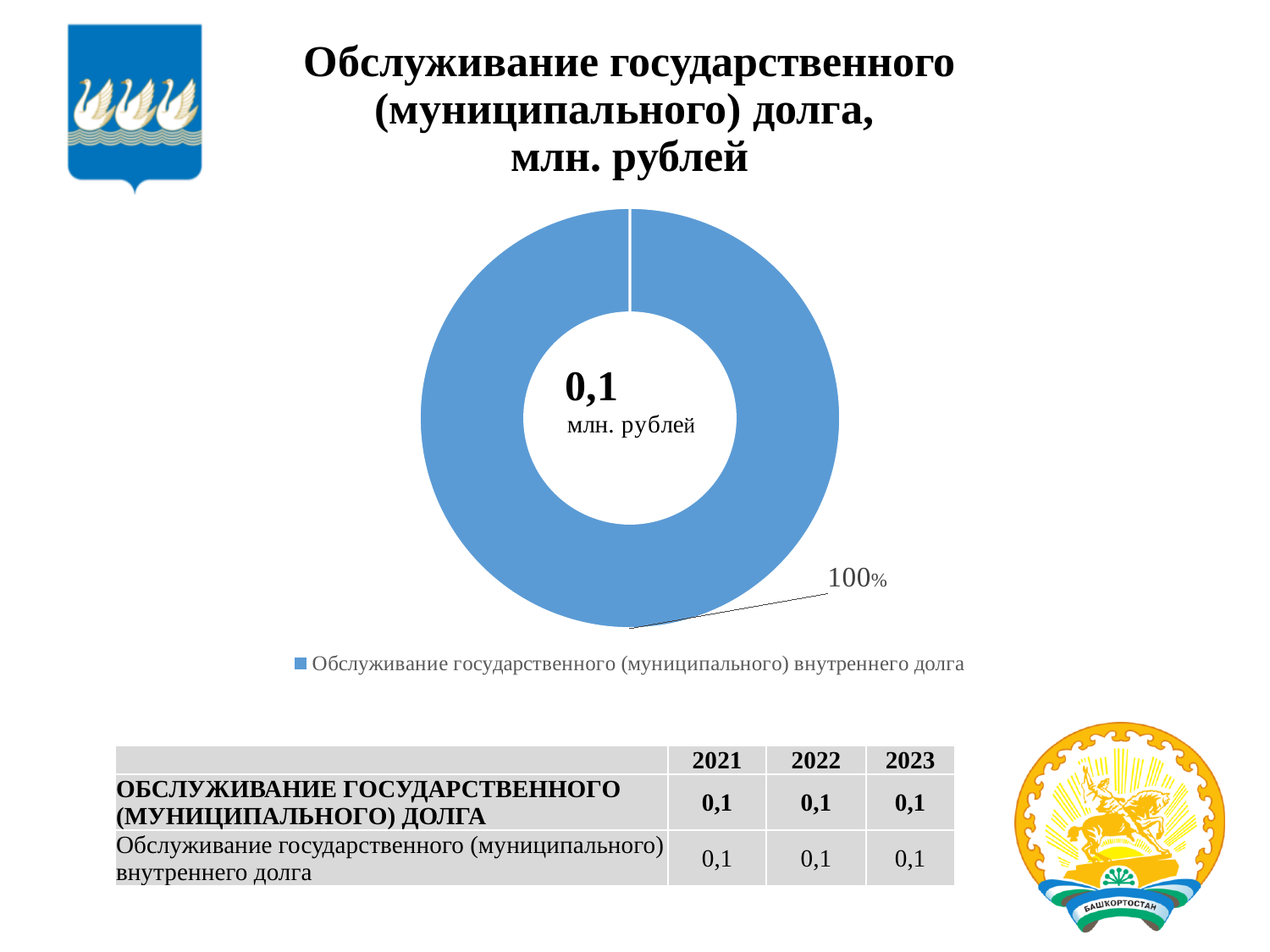
In the table below the chart, what is the value of "Обслуживание государственного (муниципального) долга" for 2022? 0,1 What share of the doughnut chart does the slice for "Обслуживание государственного (муниципального) внутреннего долга" represent? 100% What legend entry is shown below the chart? Обслуживание государственного (муниципального) внутреннего долга What total value is printed in the centre of the doughnut chart? 0,1 млн. рублей According to the table, does the value of "Обслуживание государственного (муниципального) долга" rise, fall or stay the same from 2021 to 2023? Stays the same What is the title of the chart? Обслуживание государственного (муниципального) долга, млн. рублей How many slices does the doughnut chart have? 1 In the table below the chart, what is the value of "Обслуживание государственного (муниципального) внутреннего долга" for 2023? 0,1 What kind of chart is shown on the slide? Doughnut (pie) chart How many series does the chart legend list? 1 How many years are listed in the table below the chart? 3